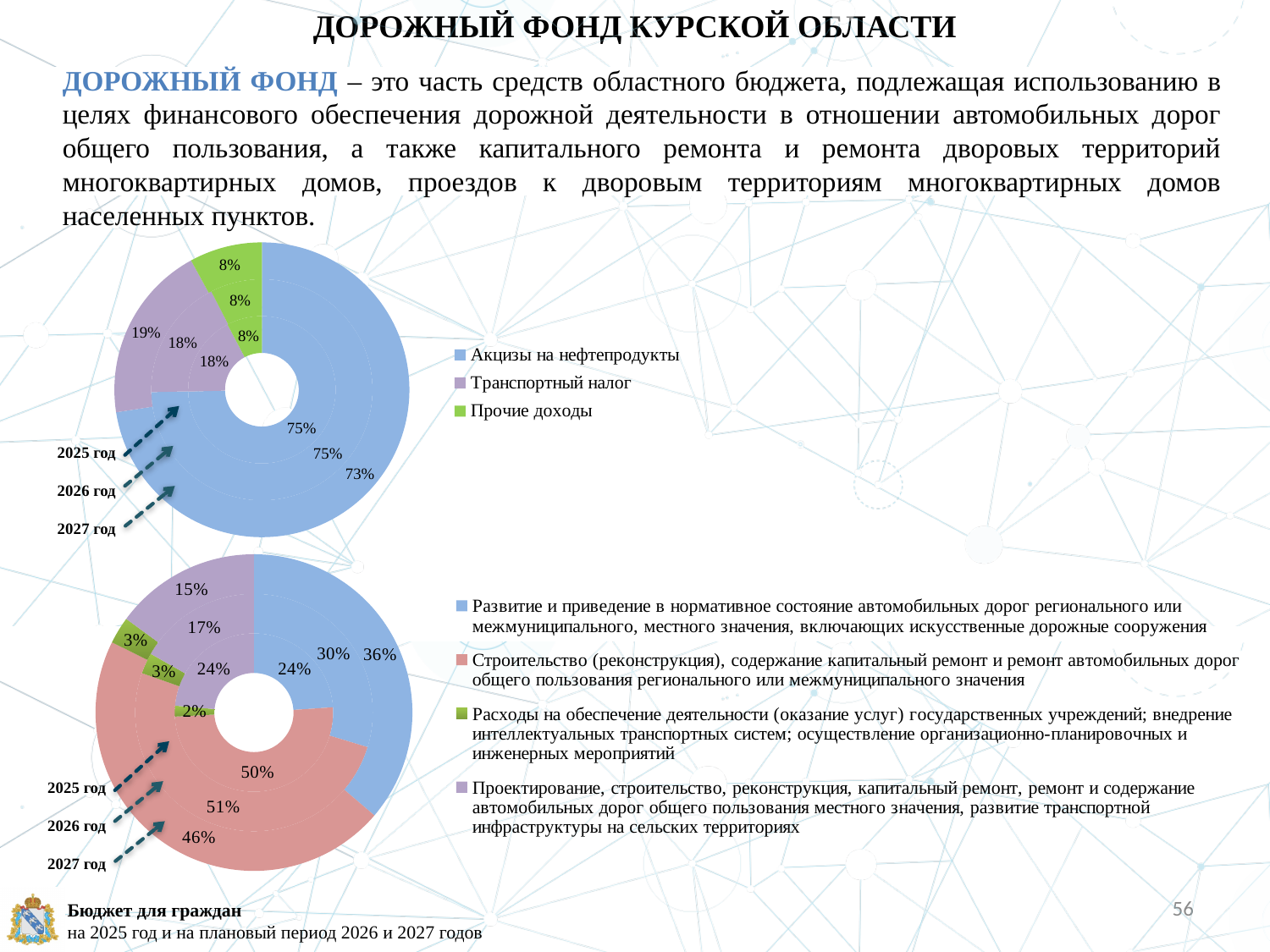
In the top chart, which category has the largest share? Акцизы на нефтепродукты In the top chart, what is the share of Транспортный налог in the outer ring (2027 год)? 19% How many series does the legend of the top chart list? 3 In the bottom chart, what is the difference between the shares of Строительство (51%) and Развитие (30%) in the middle ring (2026 год)? 21 percentage points In the top chart, what is the share of Прочие доходы in the inner ring (2025 год)? 8% In the bottom chart, what is the share of Развитие и приведение в нормативное состояние автомобильных дорог in the outer ring (2027 год)? 36% How many series does the legend of the bottom chart list? 4 In the bottom chart, what is the share of Строительство (реконструкция), содержание капитальный ремонт и ремонт автомобильных дорог in the inner ring (2025 год)? 50% In the top chart, what is the share of Акцизы на нефтепродукты in the outer ring (2027 год)? 73% What kind of chart is the top chart showing Акцизы на нефтепродукты, Транспортный налог and Прочие доходы? doughnut chart In the bottom chart, which category has the smallest share? Расходы на обеспечение деятельности (оказание услуг) государственных учреждений In the bottom chart, what is the share of Расходы на обеспечение деятельности государственных учреждений in the inner ring (2025 год)? 2%